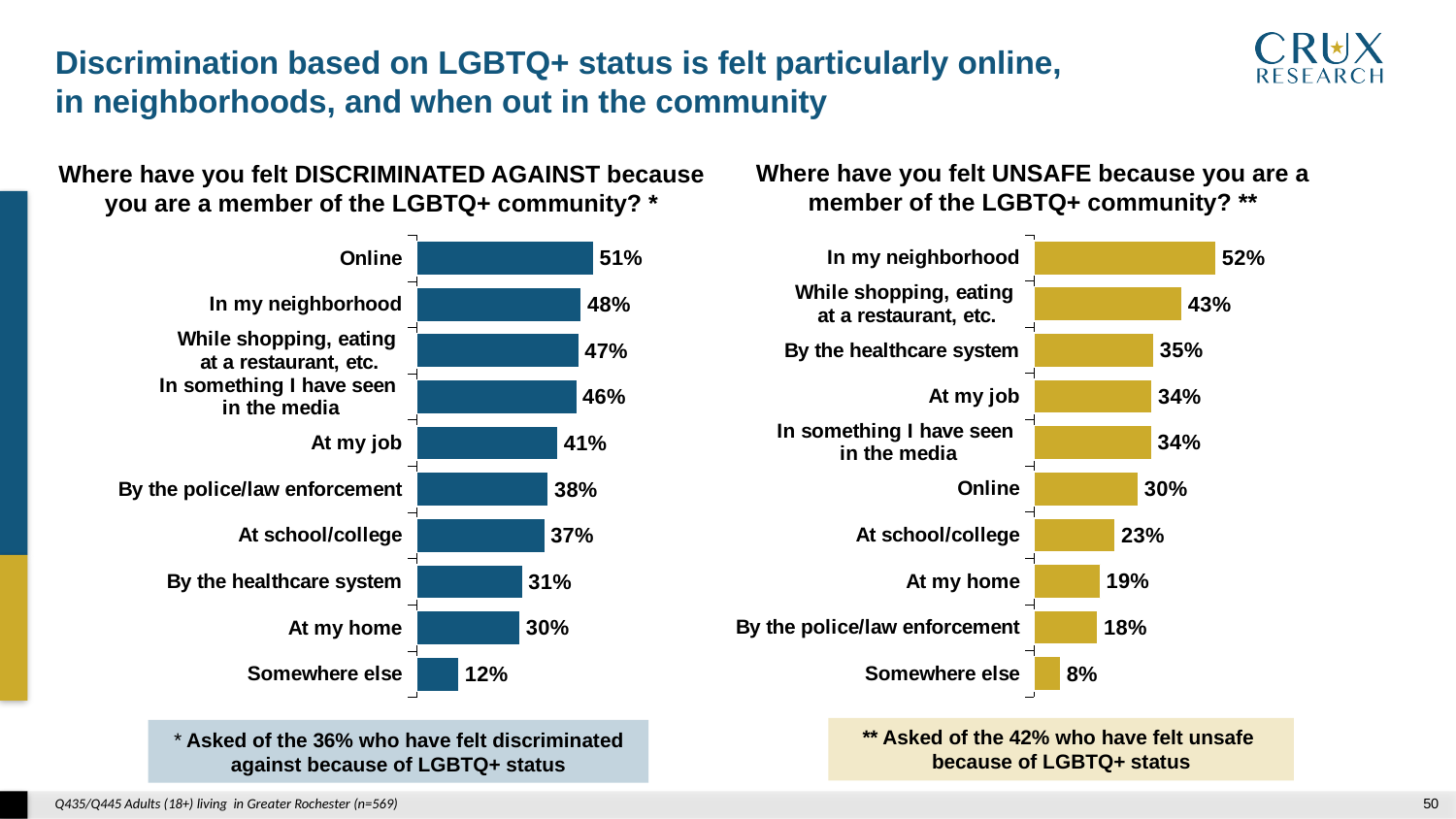
In the right chart (Where have you felt UNSAFE), what is the value for By the healthcare system? 35% In the left chart (Where have you felt DISCRIMINATED AGAINST), which category has the highest value? Online In the right chart (Where have you felt UNSAFE), what is the difference between In my neighborhood and Online? 22% In the left chart (Where have you felt DISCRIMINATED AGAINST), what is the value for Online? 51% In the right chart (Where have you felt UNSAFE), which category has the lowest value? Somewhere else In the left chart (Where have you felt DISCRIMINATED AGAINST), what is the difference between Online and Somewhere else? 39% In the right chart (Where have you felt UNSAFE), what is the value for At my home? 19% What colour are the bars in the right chart (Where have you felt UNSAFE)? Gold/yellow What kind of chart is the right chart (Where have you felt UNSAFE)? Bar chart In the left chart (Where have you felt DISCRIMINATED AGAINST), which is larger: At my job or At school/college? At my job In the left chart (Where have you felt DISCRIMINATED AGAINST), what is the value for By the police/law enforcement? 38% How many categories are shown in the left chart (Where have you felt DISCRIMINATED AGAINST)? 10